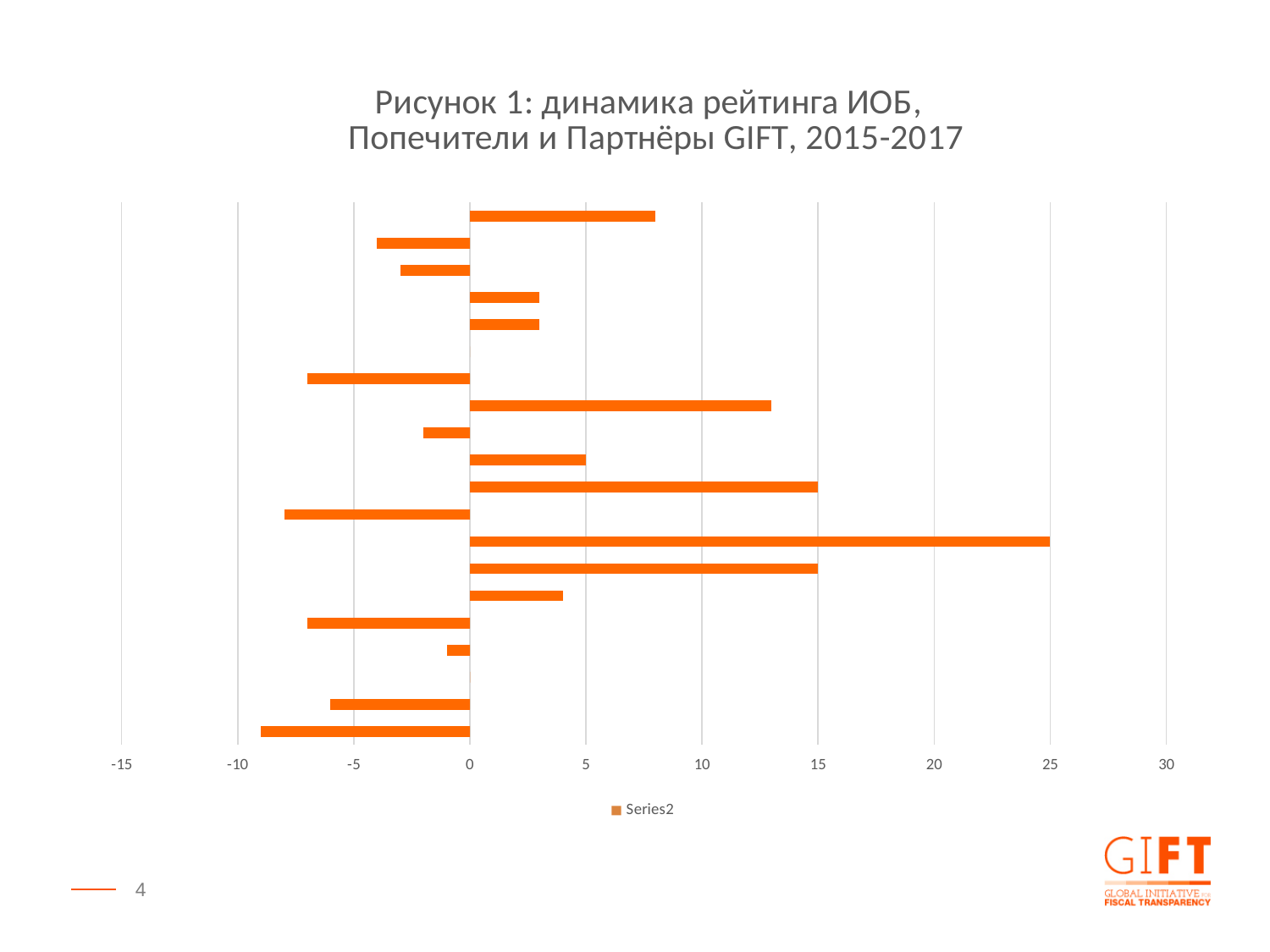
Which is larger, the value of the topmost bar or the value of the bottommost bar? the topmost bar What is the highest value shown on the horizontal axis? 30 Is the value of the bottommost bar greater or less than -5? less Is the value of the longest bar greater or less than 20? greater Is the value of the bottommost bar greater or less than -10? greater What is the name of the series shown in the legend? Series2 What is the title of the chart? Рисунок 1: динамика рейтинга ИОБ, Попечители и Партнёры GIFT, 2015-2017 What value does the longest bar reach on the horizontal axis? 25 What kind of chart is shown on the slide? bar chart How many series does the legend list? 1